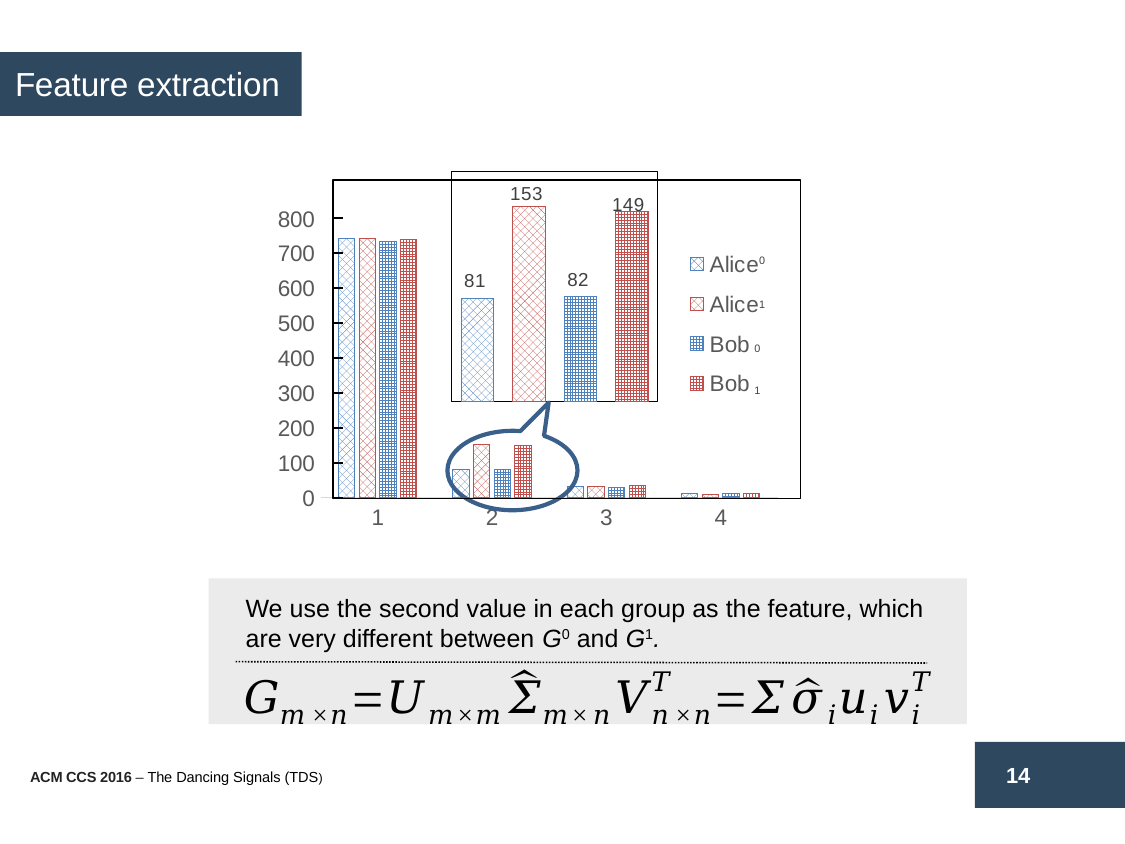
Which series has the highest value in group 2? Alice¹ What is the value for Alice¹ in group 2, as shown in the zoomed inset? 153 Which series has the lowest value in group 2? Alice⁰ What is the value for Bob₀ in group 2, as shown in the zoomed inset? 82 Is the value for Alice⁰ in group 1 greater or less than 700? greater What is the value for Alice⁰ in group 2, as shown in the zoomed inset? 81 What is the value for Bob₁ in group 2, as shown in the zoomed inset? 149 How many groups are shown on the x axis? 4 Do the values rise or fall as the group number increases from 1 to 4? fall In group 2, which is larger: the Alice¹ value or the Bob₁ value? Alice¹ What is the difference between the Alice¹ and Alice⁰ values in group 2? 72 How many series does the legend list? 4